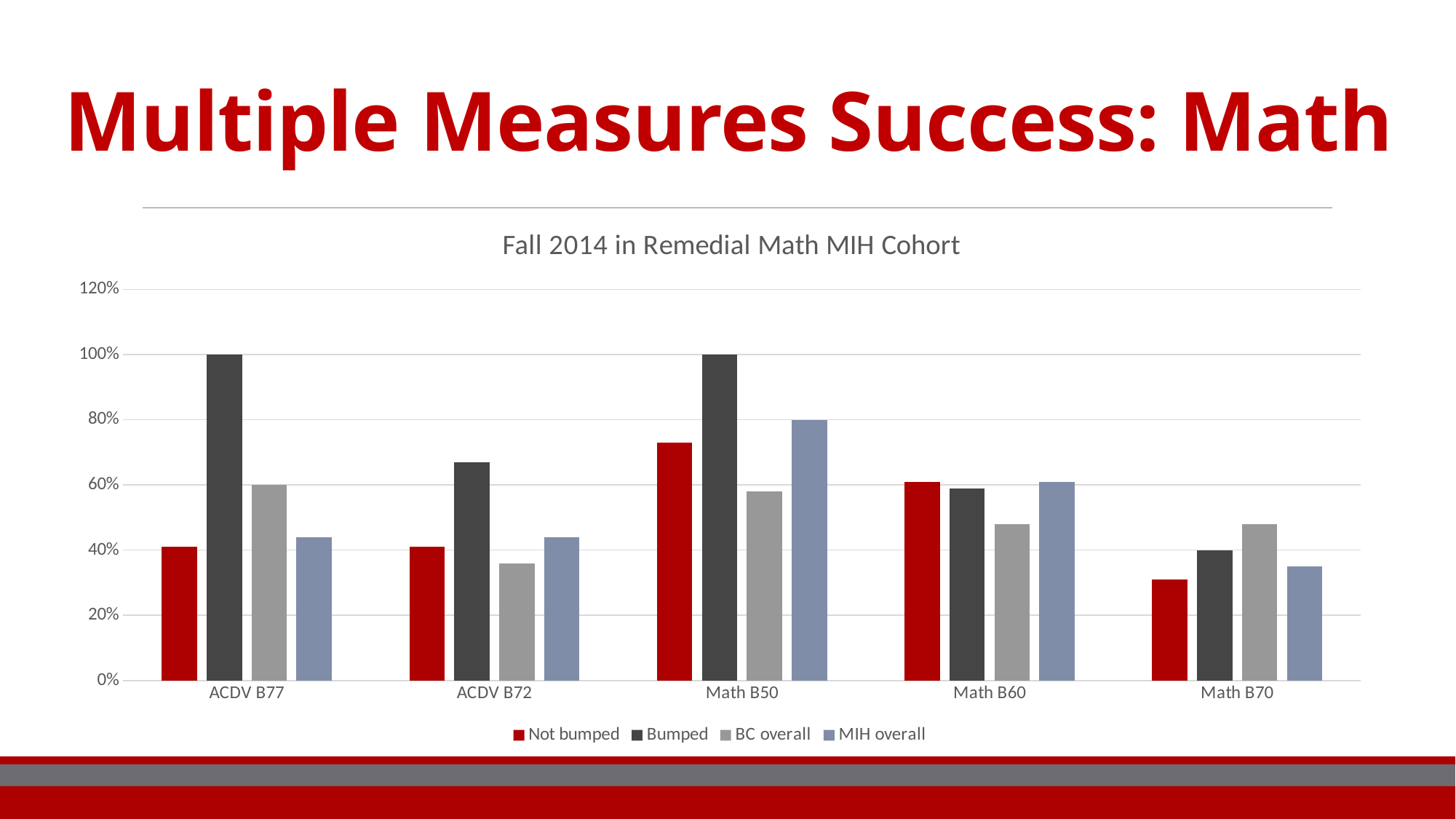
Is the Not bumped value for Math B50 greater or less than 60%? greater What is the Bumped value for ACDV B77? 100% Which series is shown in red? Not bumped How many course categories are shown on the x axis? 5 Is the Not bumped value for Math B70 greater or less than 40%? less What is the MIH overall value for Math B50? 80% What kind of chart is shown on the slide? bar chart What is the Bumped value for Math B50? 100% What is the title of the chart? Fall 2014 in Remedial Math MIH Cohort Which course has the lowest Not bumped value? Math B70 How many series does the legend list? 4 For ACDV B72, which is larger: the Bumped value or the BC overall value? Bumped